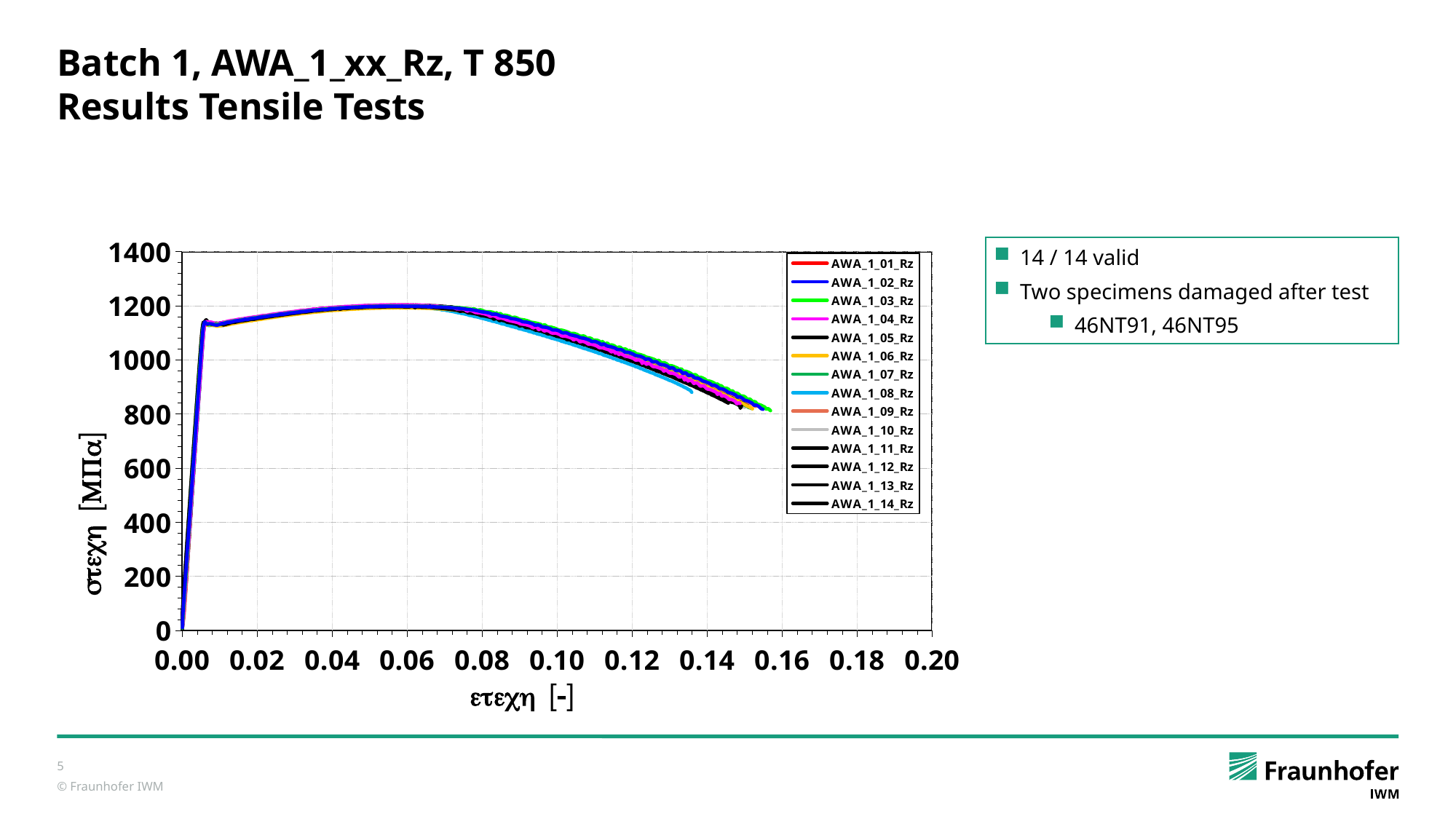
What is the highest value shown on the horizontal axis of the chart? 0.20 What is the first series listed in the chart legend? AWA_1_01_Rz Is the peak stress reached by the curves greater or less than 1000? greater How many series does the chart legend list? 14 Is the stress at the end of the curves greater or less than 1000? less What is the highest value shown on the vertical axis of the chart? 1400 Is the strain at which the curves end greater or less than 0.18? less What kind of chart is shown on the slide? line chart After reaching their peak, do the curves rise or fall as strain increases? fall What is the last series listed in the chart legend? AWA_1_14_Rz How many tick labels are shown on the horizontal axis of the chart? 11